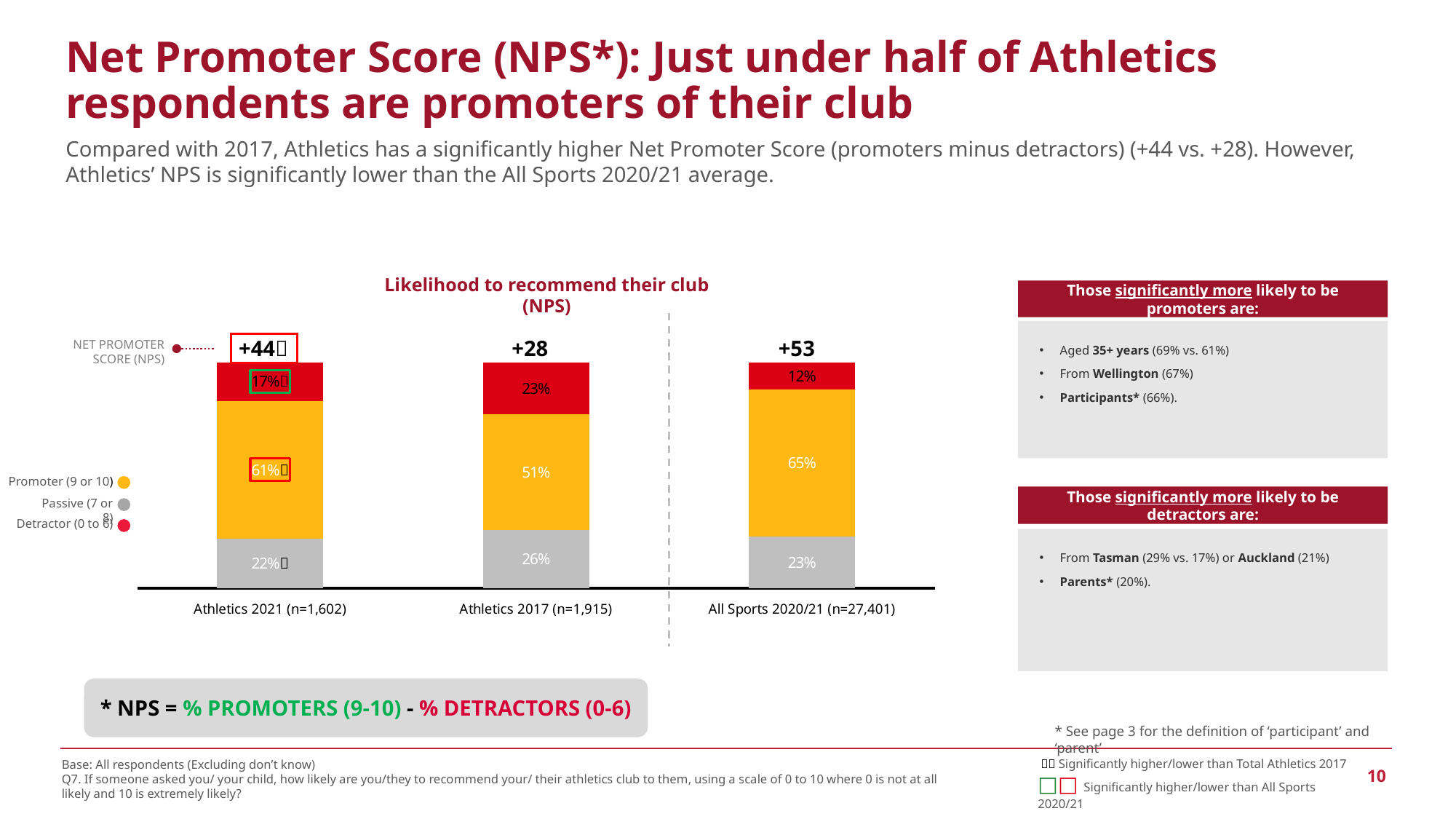
Which group has the lowest percentage of promoters? Athletics 2017 (n=1,915) How many groups (bars) are shown in the chart? 3 What is the Net Promoter Score shown for Athletics 2017 (n=1,915)? +28 How many categories does the legend list? 3 What percentage of All Sports 2020/21 respondents are promoters (9 or 10)? 65% What type of chart is used to show likelihood to recommend their club? Stacked bar chart What percentage of Athletics 2017 respondents are detractors (0 to 6)? 23% What is the Net Promoter Score shown for Athletics 2021 (n=1,602)? +44 What percentage of Athletics 2021 respondents are passive (7 or 8)? 22% Which has a larger detractor percentage, Athletics 2021 or All Sports 2020/21? Athletics 2021 What is the difference between the promoter percentage for Athletics 2021 and Athletics 2017? 10 percentage points Which group has the highest Net Promoter Score? All Sports 2020/21 (n=27,401)